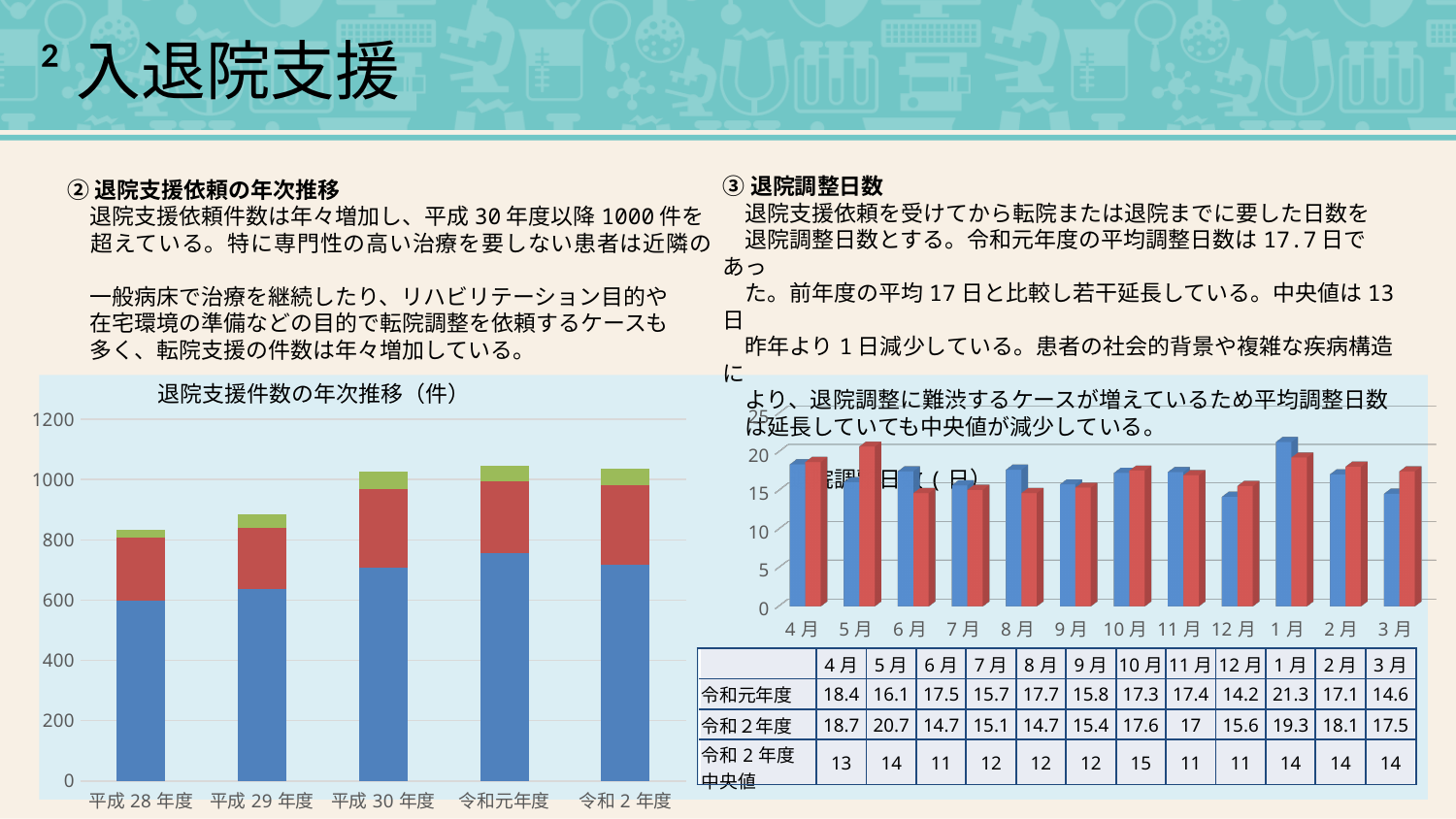
In the left chart titled 退院支援件数の年次推移（件）, which fiscal year has the lowest total bar? 平成28年度 In the right chart (退院調整日数), what is the difference between the 令和2年度 and 令和元年度 values for 4月? 0.3 In the right chart (退院調整日数), which month has the lowest value for 令和元年度? 12月 In the left chart titled 退院支援件数の年次推移（件）, is the total bar height for 令和元年度 greater or less than 1000? greater In the left chart titled 退院支援件数の年次推移（件）, is the total bar height for 平成28年度 greater or less than 1000? less In the left chart titled 退院支援件数の年次推移（件）, how many fiscal-year categories are shown on the x axis? 5 What kind of chart is the left chart titled 退院支援件数の年次推移（件）? stacked bar chart In the left chart titled 退院支援件数の年次推移（件）, is the blue segment for 令和2年度 greater or less than 600? greater In the right chart (退院調整日数), what is the value for 令和2年度 in 5月? 20.7 In the right chart (退院調整日数), which is larger in 6月: the 令和元年度 value or the 令和2年度 value? 令和元年度 In the right chart (退院調整日数), what is the value for 令和元年度 in 1月? 21.3 In the right chart (退院調整日数), which month has the highest value for 令和元年度? 1月